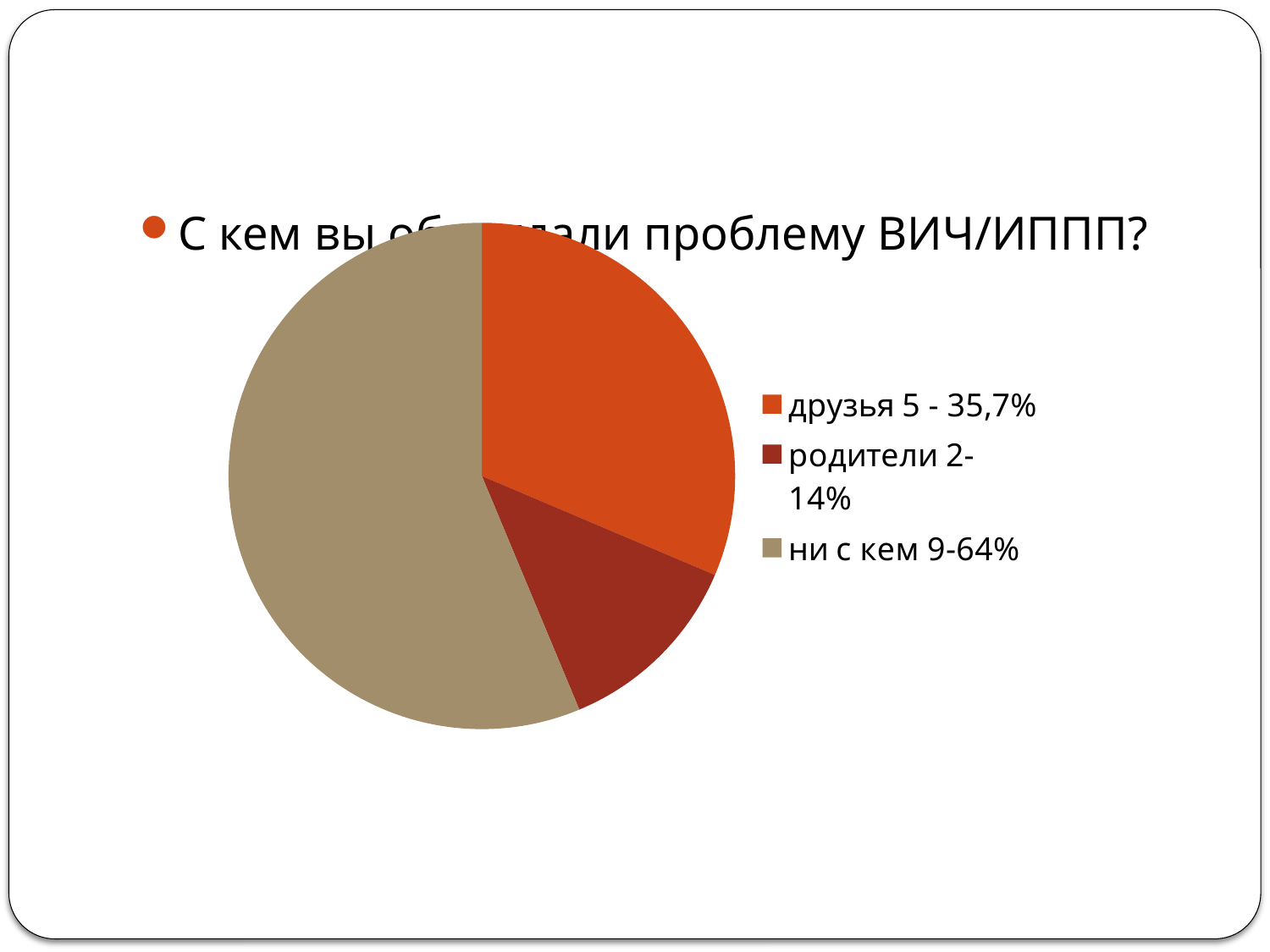
How many respondents are listed for "друзья" in the legend? 5 How many slices does the pie chart have? 3 How many entries does the legend list? 3 What percentage share is shown for "друзья"? 35,7% What percentage share is shown for "ни с кем"? 64% What kind of chart is shown on the slide? pie chart What percentage share is shown for "родители"? 14% Which slice is larger, "друзья" or "родители"? друзья Which category has the smallest slice of the pie? родители How many respondents are listed for "ни с кем" in the legend? 9 Which category has the largest slice of the pie? ни с кем What is the difference in percentage points between "ни с кем" and "друзья"? 28,3%